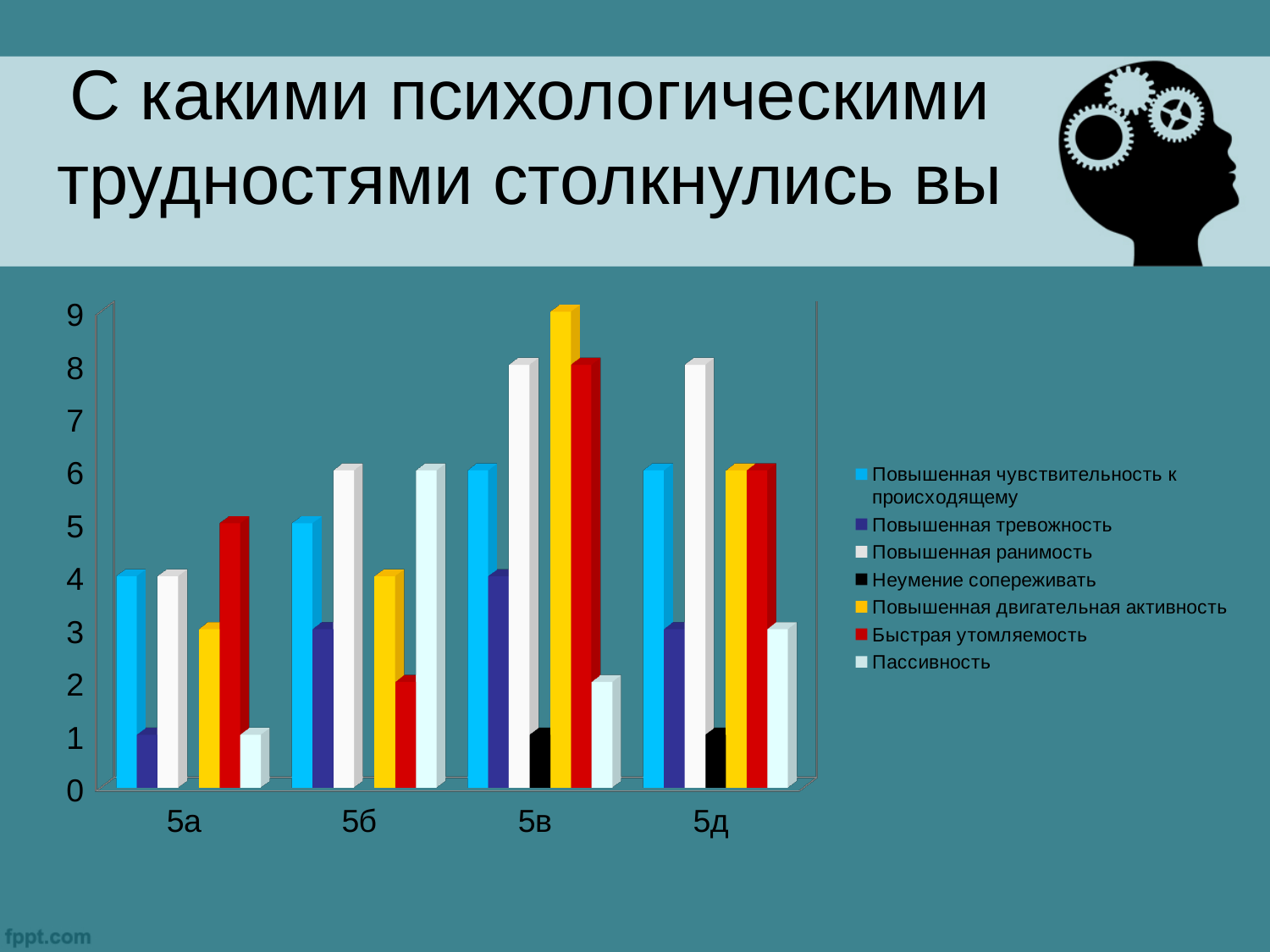
How many categories are shown on the x axis of the chart? 4 Is the value for Повышенная двигательная активность in category 5в greater or less than 8? greater What kind of chart is shown on the slide? bar chart How many series does the chart's legend list? 7 Is the value for Быстрая утомляемость in category 5б greater or less than 3? less Is the value for Повышенная ранимость in category 5д greater or less than 7? greater Which is larger in category 5б: Повышенная ранимость or Повышенная тревожность? Повышенная ранимость Which legend entry is shown in black? Неумение сопереживать Which series has the highest bar in category 5в? Повышенная двигательная активность Which category has the tallest bar in the chart? 5в Which is larger in category 5а: Быстрая утомляемость or Повышенная двигательная активность? Быстрая утомляемость